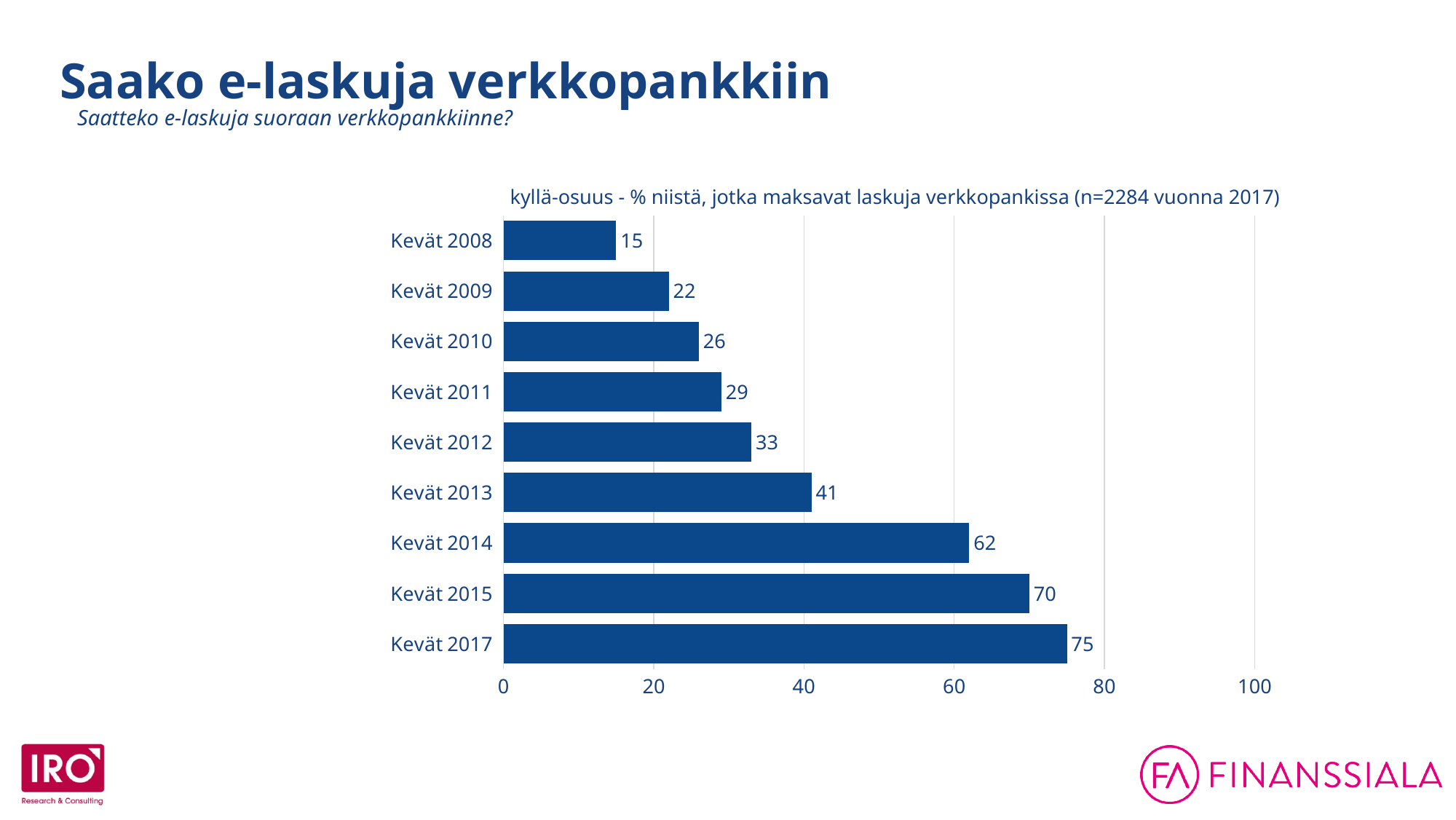
Which category has the highest value? Kevät 2017 Do the values rise or fall from Kevät 2008 to Kevät 2017? rise How many categories are shown in the chart? 9 What is the difference between the values for Kevät 2014 and Kevät 2013? 21 What is the value for Kevät 2013? 41 What is the difference between the values for Kevät 2017 and Kevät 2008? 60 What kind of chart is shown on the slide? bar chart Which is larger, the value for Kevät 2012 or the value for Kevät 2011? Kevät 2012 Which category has the lowest value? Kevät 2008 Is the value for Kevät 2014 greater or less than 60? greater What is the value for Kevät 2008? 15 What is the value for Kevät 2015? 70